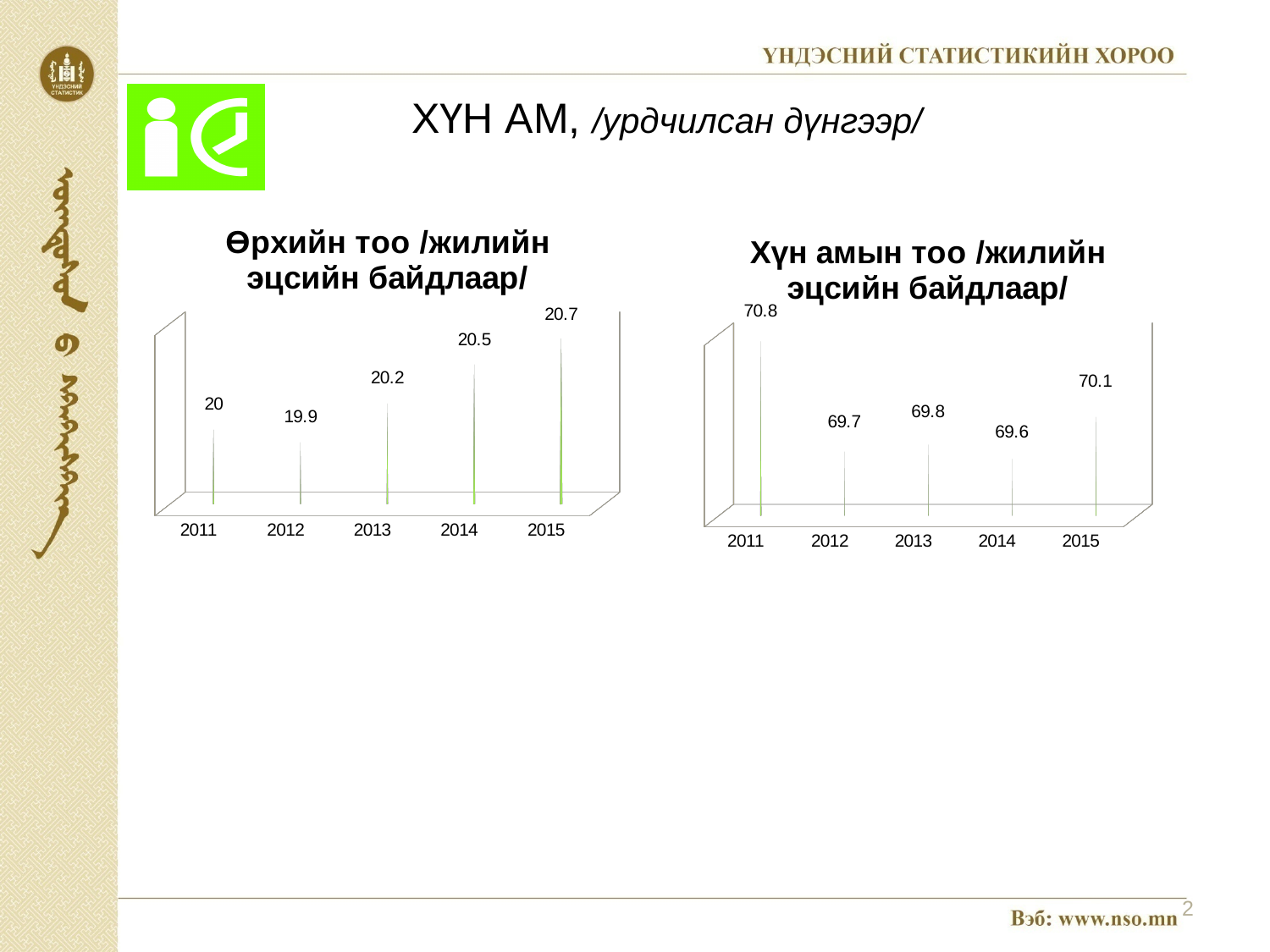
In the chart titled 'Хүн амын тоо /жилийн эцсийн байдлаар/', which year has the highest value? 2011 In the chart titled 'Өрхийн тоо /жилийн эцсийн байдлаар/', which year has the lowest value? 2012 What kind of chart is the chart titled 'Өрхийн тоо /жилийн эцсийн байдлаар/'? Bar chart In the chart titled 'Хүн амын тоо /жилийн эцсийн байдлаар/', what is the value for 2011? 70.8 In the chart titled 'Өрхийн тоо /жилийн эцсийн байдлаар/', what is the value for 2013? 20.2 In the chart titled 'Хүн амын тоо /жилийн эцсийн байдлаар/', what is the value for 2015? 70.1 In the chart titled 'Өрхийн тоо /жилийн эцсийн байдлаар/', what is the difference between the values for 2015 and 2011? 0.7 In the chart titled 'Хүн амын тоо /жилийн эцсийн байдлаар/', what is the difference between the values for 2011 and 2012? 1.1 In the chart titled 'Өрхийн тоо /жилийн эцсийн байдлаар/', how many years are shown on the x axis? 5 In the chart titled 'Хүн амын тоо /жилийн эцсийн байдлаар/', which year has the lowest value? 2014 In the chart titled 'Хүн амын тоо /жилийн эцсийн байдлаар/', which is larger, the value for 2013 or the value for 2014? 2013 In the chart titled 'Өрхийн тоо /жилийн эцсийн байдлаар/', which year has the highest value? 2015